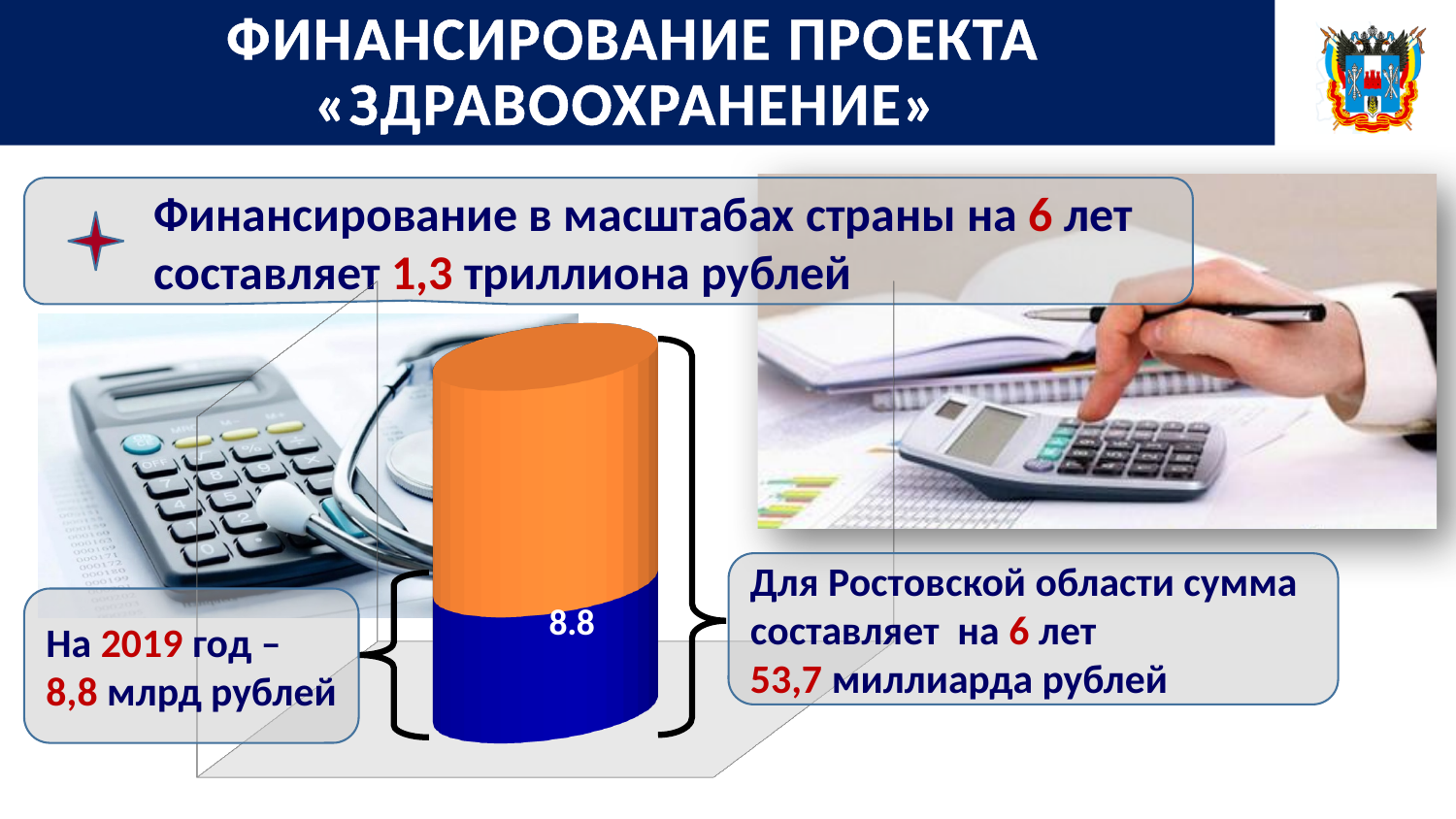
Which segment of the stacked bar is the smallest? blue What colour is the bottom segment of the stacked bar? blue What value is printed on the blue (bottom) segment of the stacked bar? 8.8 Which segment of the stacked bar is larger, the blue one or the orange one? orange What colour is the top segment of the stacked bar? orange Does the chart display a legend? no How many bars does the chart contain? 1 How many segments make up the stacked bar? 2 What kind of chart is shown on the slide? bar chart